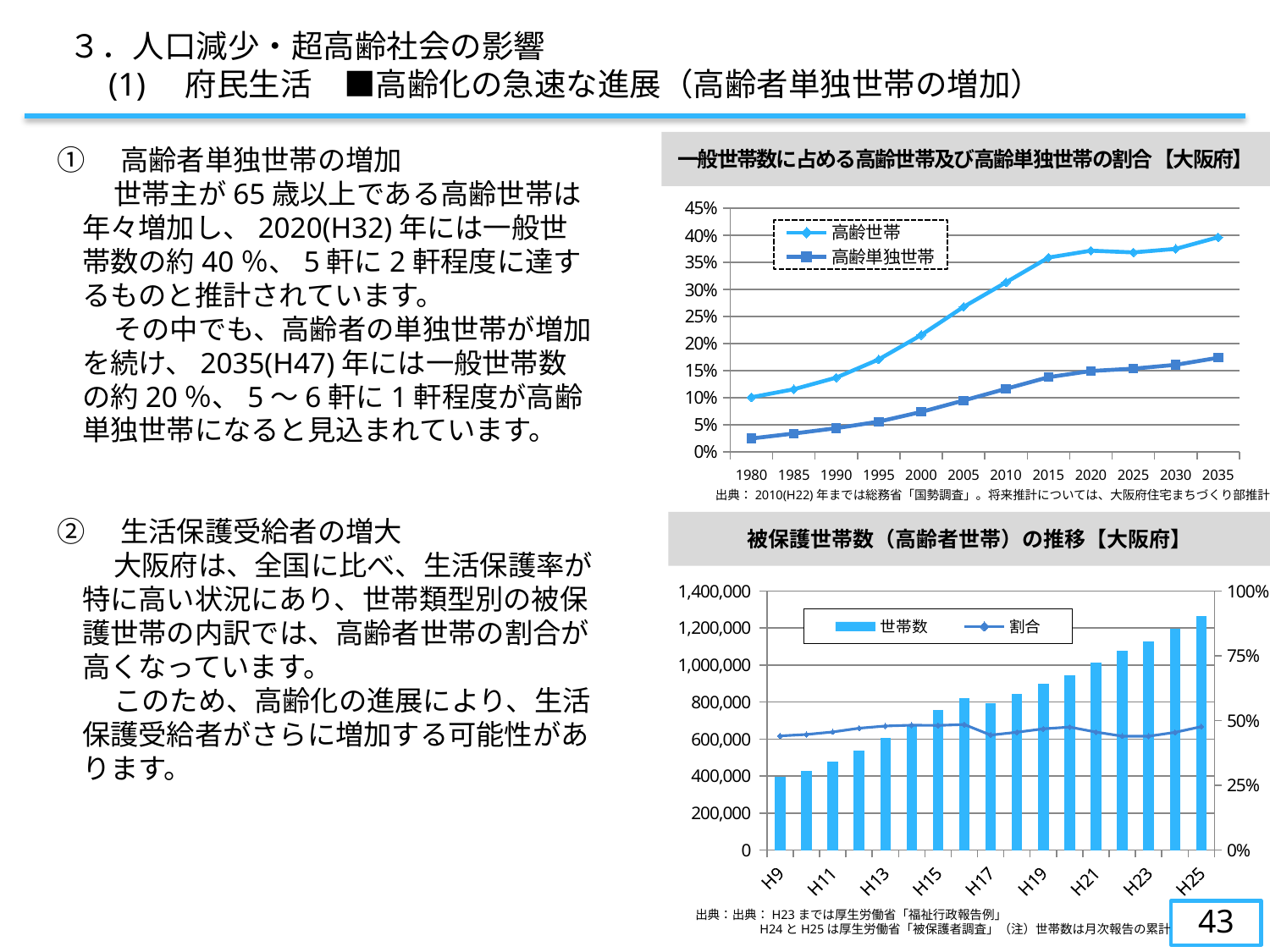
In the top chart (一般世帯数に占める高齢世帯及び高齢単独世帯の割合【大阪府】), how many series does the legend list? 2 In the top chart (一般世帯数に占める高齢世帯及び高齢単独世帯の割合【大阪府】), is the value for 高齢単独世帯 in 2035 greater or less than 15%? greater In the top chart (一般世帯数に占める高齢世帯及び高齢単独世帯の割合【大阪府】), which series is higher in 2020, 高齢世帯 or 高齢単独世帯? 高齢世帯 In the bottom chart (被保護世帯数（高齢者世帯）の推移【大阪府】), do the 世帯数 bars rise or fall from H9 to H25? rise In the top chart (一般世帯数に占める高齢世帯及び高齢単独世帯の割合【大阪府】), how many years are shown on the x axis? 12 In the bottom chart (被保護世帯数（高齢者世帯）の推移【大阪府】), what kind of chart is used for the 世帯数 series? bar chart In the bottom chart (被保護世帯数（高齢者世帯）の推移【大阪府】), how many series does the legend list? 2 In the top chart (一般世帯数に占める高齢世帯及び高齢単独世帯の割合【大阪府】), do the values for 高齢単独世帯 rise or fall from 1980 to 2035? rise In the bottom chart (被保護世帯数（高齢者世帯）の推移【大阪府】), is the 世帯数 value for H25 greater or less than 1,200,000? greater In the top chart (一般世帯数に占める高齢世帯及び高齢単独世帯の割合【大阪府】), is the value for 高齢世帯 in 2035 greater or less than 35%? greater In the top chart (一般世帯数に占める高齢世帯及び高齢単独世帯の割合【大阪府】), what kind of chart is it? line chart